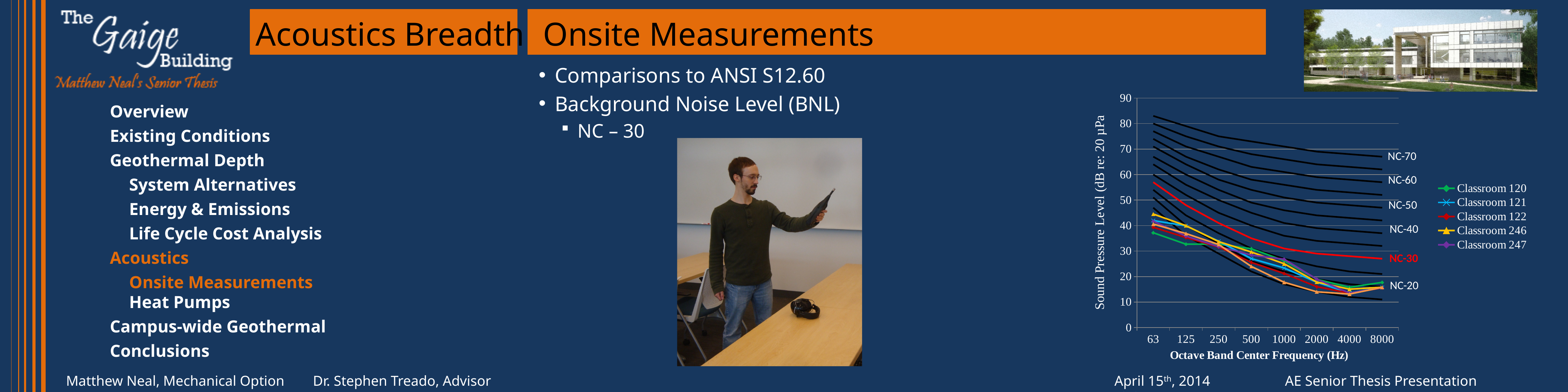
How many classroom series does the chart legend list? 5 What kind of chart is shown on the slide? line chart Is the sound pressure level for Classroom 122 at 63 Hz greater or less than 50? less What is the title of the y axis of the chart? Sound Pressure Level (dB re: 20 µPa) Is the sound pressure level for Classroom 122 at 8000 Hz greater or less than 20? less What is the title of the x axis of the chart? Octave Band Center Frequency (Hz) Do the classroom sound pressure levels generally rise or fall as frequency increases along the x axis? fall Is the sound pressure level for Classroom 246 at 4000 Hz greater or less than 20? less Which classroom has the highest sound pressure level at 63 Hz? Classroom 246 How many octave band center frequencies are shown on the x axis of the chart? 8